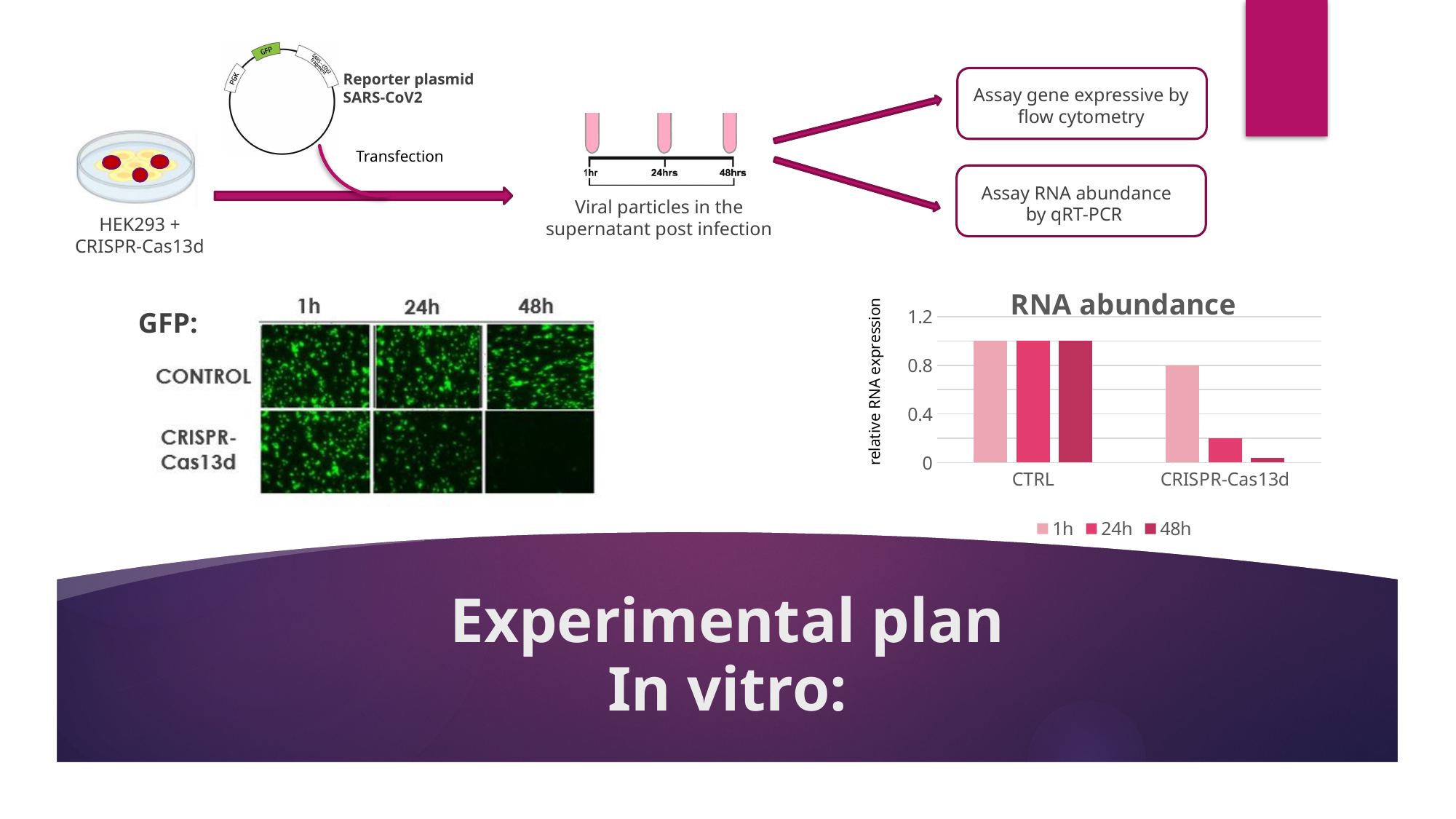
What is the title of the bar chart on the slide? RNA abundance In the RNA abundance chart, is the value for CRISPR-Cas13d at 48h greater or less than 0.4? less In the RNA abundance chart, is the 24h value larger for CTRL or for CRISPR-Cas13d? CTRL In the RNA abundance chart, which time point has the lowest value for CRISPR-Cas13d? 48h What is the y-axis label of the RNA abundance chart? relative RNA expression In the RNA abundance chart, which time point has the highest value for CRISPR-Cas13d? 1h What kind of chart is the RNA abundance chart? bar chart How many series does the legend of the RNA abundance chart list? 3 How many categories are shown on the x axis of the RNA abundance chart? 2 In the RNA abundance chart, is the value for CTRL at 1h greater or less than 0.8? greater In the RNA abundance chart, what is the relative RNA expression for CRISPR-Cas13d at 1h? 0.8 In the RNA abundance chart, do the CRISPR-Cas13d values rise or fall from 1h to 48h? fall